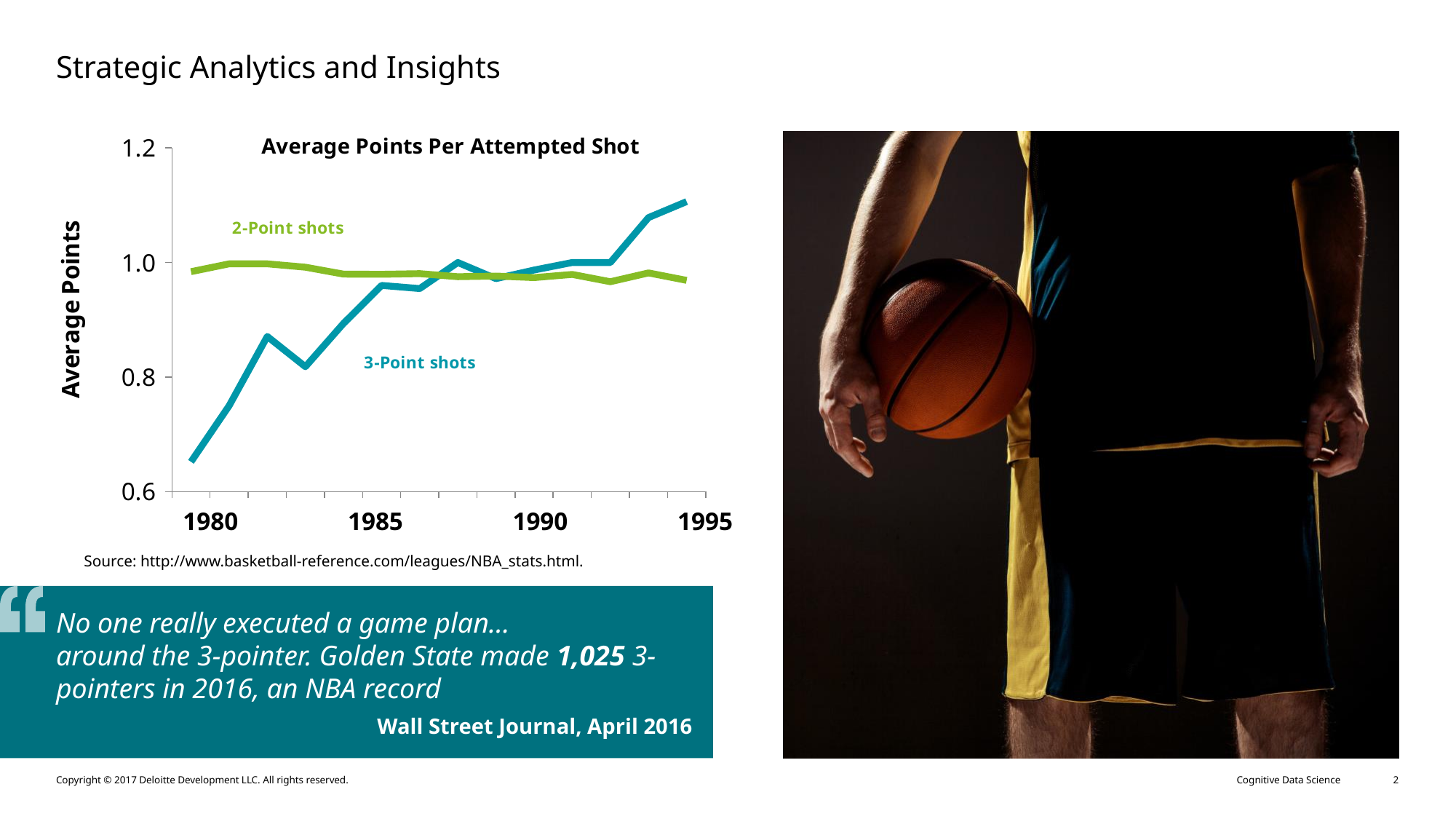
What is the label on the vertical axis of the chart? Average Points Is the value for 3-Point shots in 1980 greater or less than 0.8? less Is the value for 3-Point shots at the end of the series (around 1995) greater or less than 1.0? greater Which series reaches the highest value shown on the chart? 3-Point shots At the end of the series (around 1995), which line is higher, 2-Point shots or 3-Point shots? 3-Point shots What kind of chart is shown on the slide? Line chart Which series reaches the lowest value shown on the chart? 3-Point shots What is the title of the chart? Average Points Per Attempted Shot Does the 3-Point shots line generally rise or fall from 1980 to 1995? Rise Is the value for 2-Point shots in 1980 greater or less than 0.8? greater How many series are plotted in the "Average Points Per Attempted Shot" chart? 2 In 1980, which series has the higher average points per attempted shot, 2-Point shots or 3-Point shots? 2-Point shots